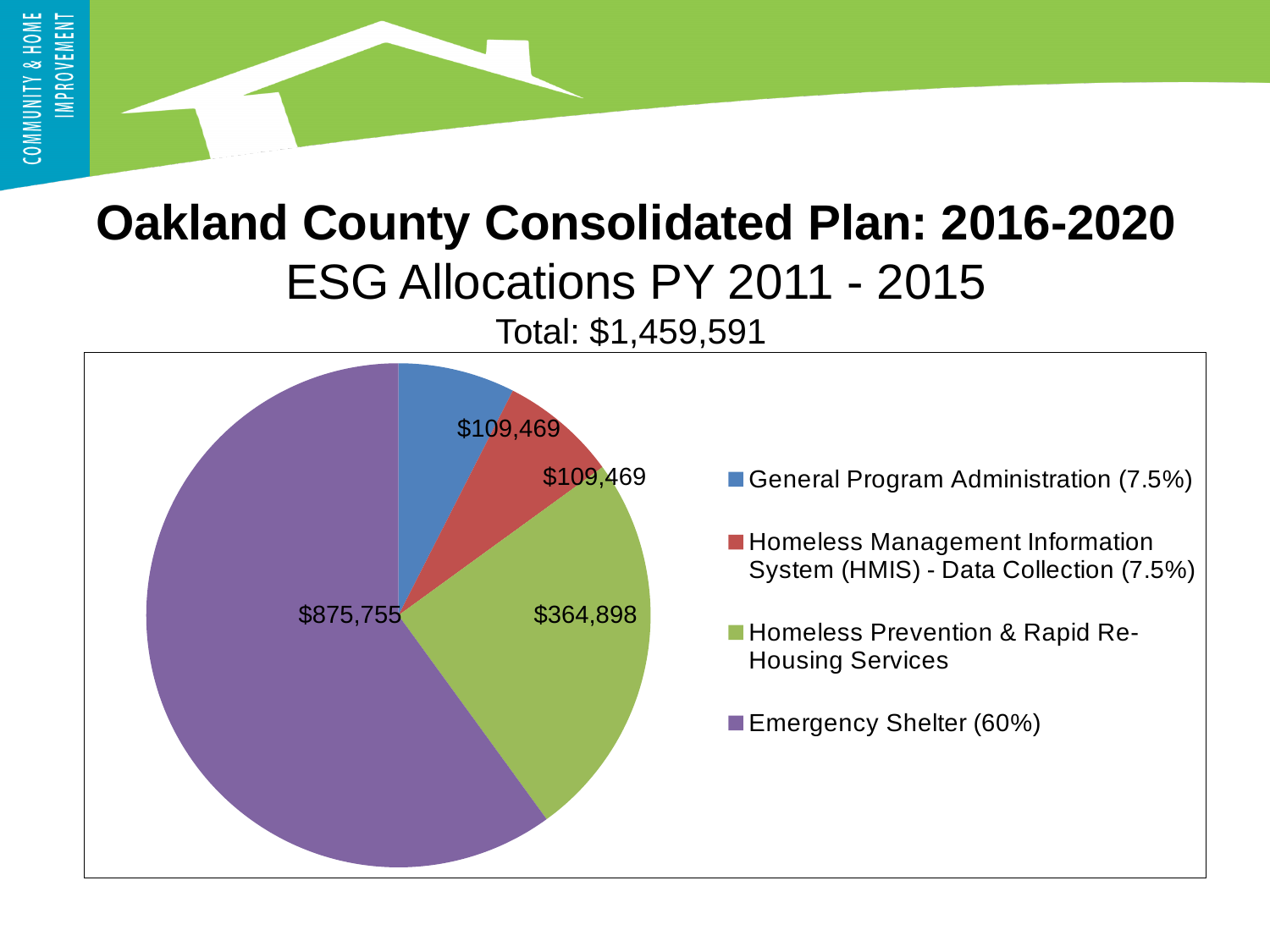
What type of chart is shown on the slide? Pie chart How many entries does the legend list? 4 What is the difference between the Homeless Prevention & Rapid Re-Housing Services value and the Homeless Management Information System (HMIS) - Data Collection value? $255,429 What is the value for General Program Administration? $109,469 How many slices does the pie chart have? 4 Which category has the largest slice of the pie? Emergency Shelter Which is larger, the value for Emergency Shelter or the value for Homeless Prevention & Rapid Re-Housing Services? Emergency Shelter What share of the total does Emergency Shelter represent? 60% What is the difference between the Emergency Shelter value and the Homeless Prevention & Rapid Re-Housing Services value? $510,857 What is the value for Homeless Prevention & Rapid Re-Housing Services? $364,898 What is the value for Emergency Shelter? $875,755 What total is stated above the pie chart? $1,459,591